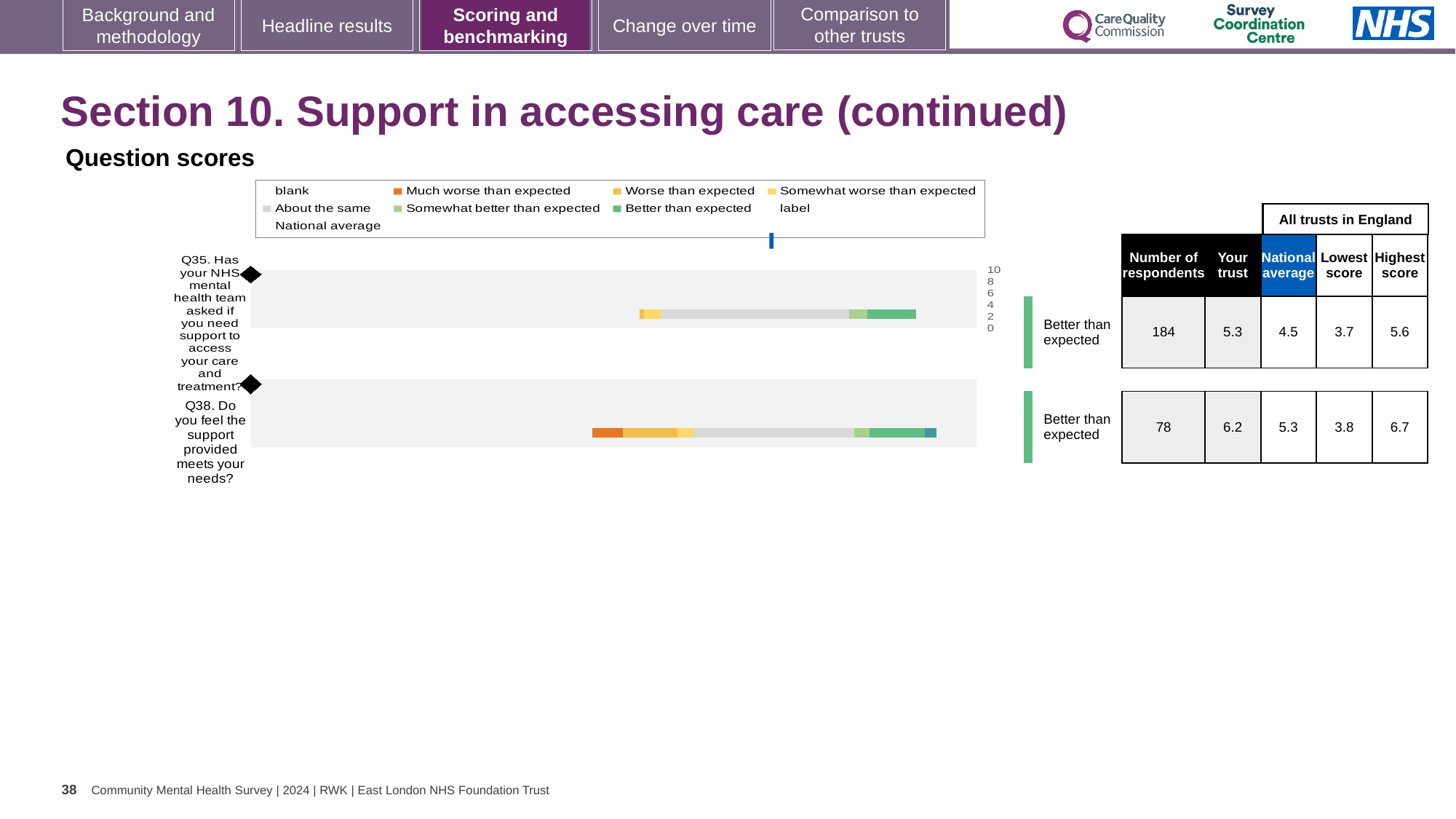
What is the 'Your trust' score for Q38 (Do you feel the support provided meets your needs?)? 6.2 What is the 'Your trust' score for Q35 (Has your NHS mental health team asked if you need support to access your care and treatment?)? 5.3 What is the difference between the 'Your trust' score and the national average for Q38? 0.9 What is the national average for Q38? 5.3 Which legend entry is shown in orange? Much worse than expected What is the number of respondents for Q35? 184 What benchmark category is shown for Q35? Better than expected Which question has the higher 'Your trust' score, Q35 or Q38? Q38 What kind of chart is used to show the question scores? bar chart What is the lowest score across all trusts in England for Q35? 3.7 How many questions are plotted in the Question scores chart? 2 What is the highest score across all trusts in England for Q38? 6.7